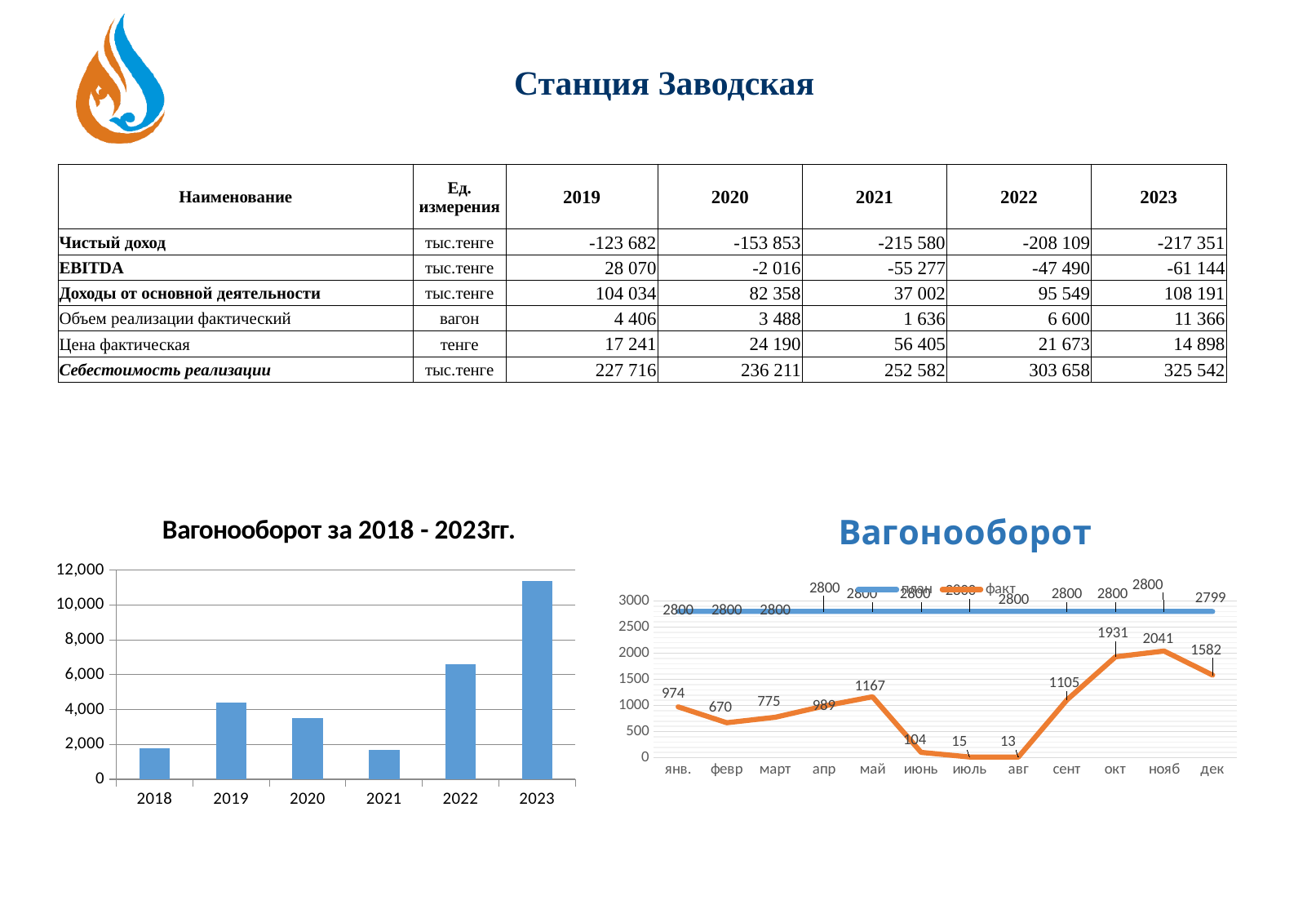
In the left chart 'Вагонооборот за 2018 - 2023гг.', which is larger, the value for 2019 or the value for 2020? 2019 In the right chart 'Вагонооборот', which month has the lowest факт value? авг In the left chart 'Вагонооборот за 2018 - 2023гг.', how many years are shown on the x axis? 6 In the right chart 'Вагонооборот', what is the факт value for нояб? 2041 In the right chart 'Вагонооборот', what is the difference between the факт values for окт and сент? 826 In the right chart 'Вагонооборот', what is the факт value for май? 1167 In the right chart 'Вагонооборот', what is the план value for дек? 2799 What type of chart is the left chart titled 'Вагонооборот за 2018 - 2023гг.'? bar chart In the left chart 'Вагонооборот за 2018 - 2023гг.', which year has the highest value? 2023 In the left chart 'Вагонооборот за 2018 - 2023гг.', is the value for 2023 greater or less than 10,000? greater In the right chart 'Вагонооборот', how many series does the legend list? 2 In the left chart 'Вагонооборот за 2018 - 2023гг.', is the value for 2022 greater or less than 6,000? greater